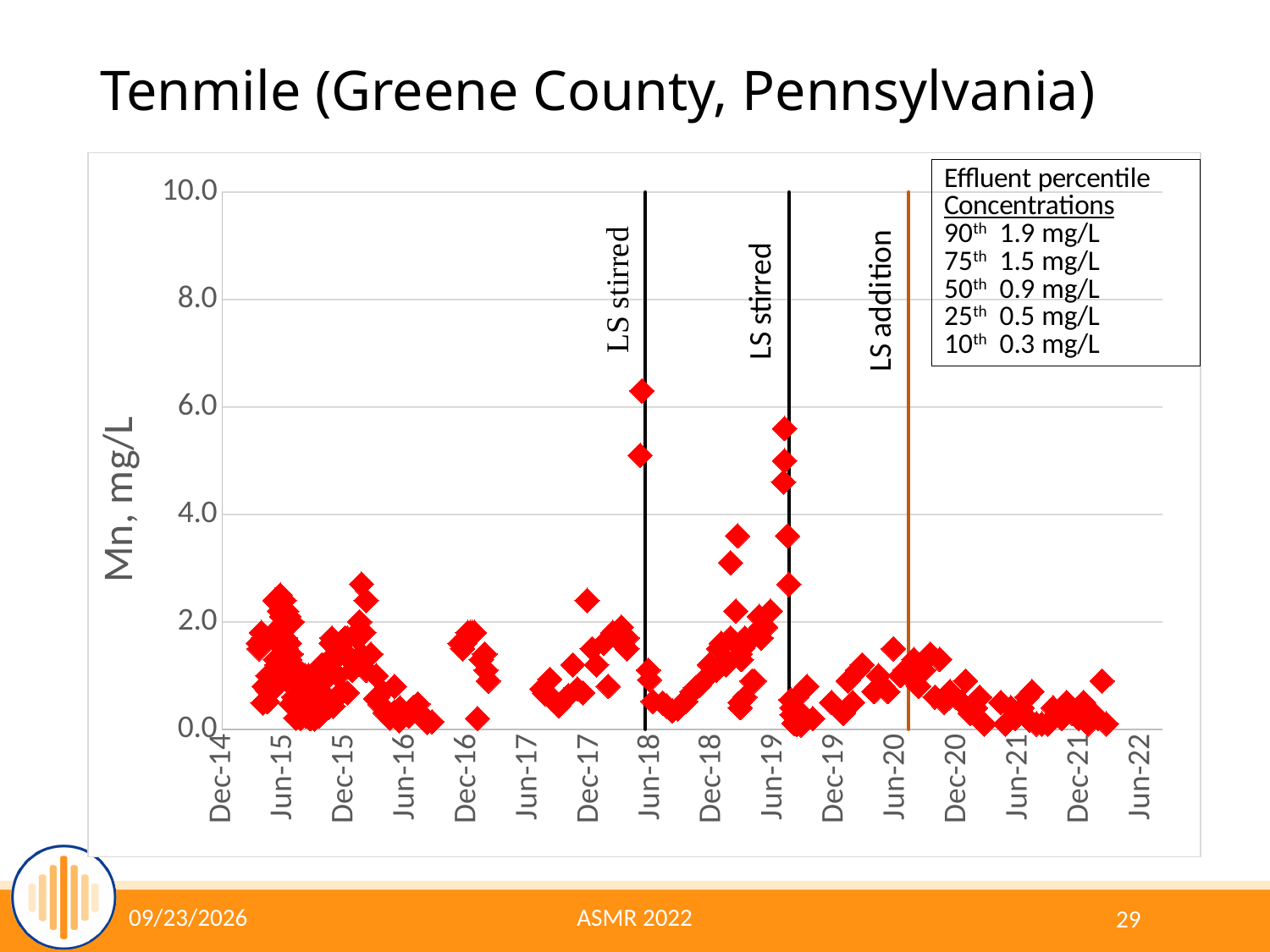
According to the text box on the chart, what is the 90th percentile effluent Mn concentration? 1.9 mg/L Is the highest plotted Mn value near Jun-19 greater or less than 4.0? greater What is the highest value shown on the y axis of the chart? 10.0 Which is larger according to the text box: the 75th percentile or the 25th percentile effluent Mn concentration? 75th percentile How many vertical event lines are drawn on the chart? 3 Do the plotted Mn values generally rise or fall after the LS addition line? fall According to the text box on the chart, what is the 50th percentile effluent Mn concentration? 0.9 mg/L What is the label on the y axis of the chart? Mn, mg/L What kind of chart is shown on the slide? Scatter chart Is the highest plotted Mn value on the chart greater or less than 6.0? greater Are the plotted Mn values after Dec-20 greater or less than 2.0? less Near which x-axis label does the highest plotted Mn value occur? Jun-18